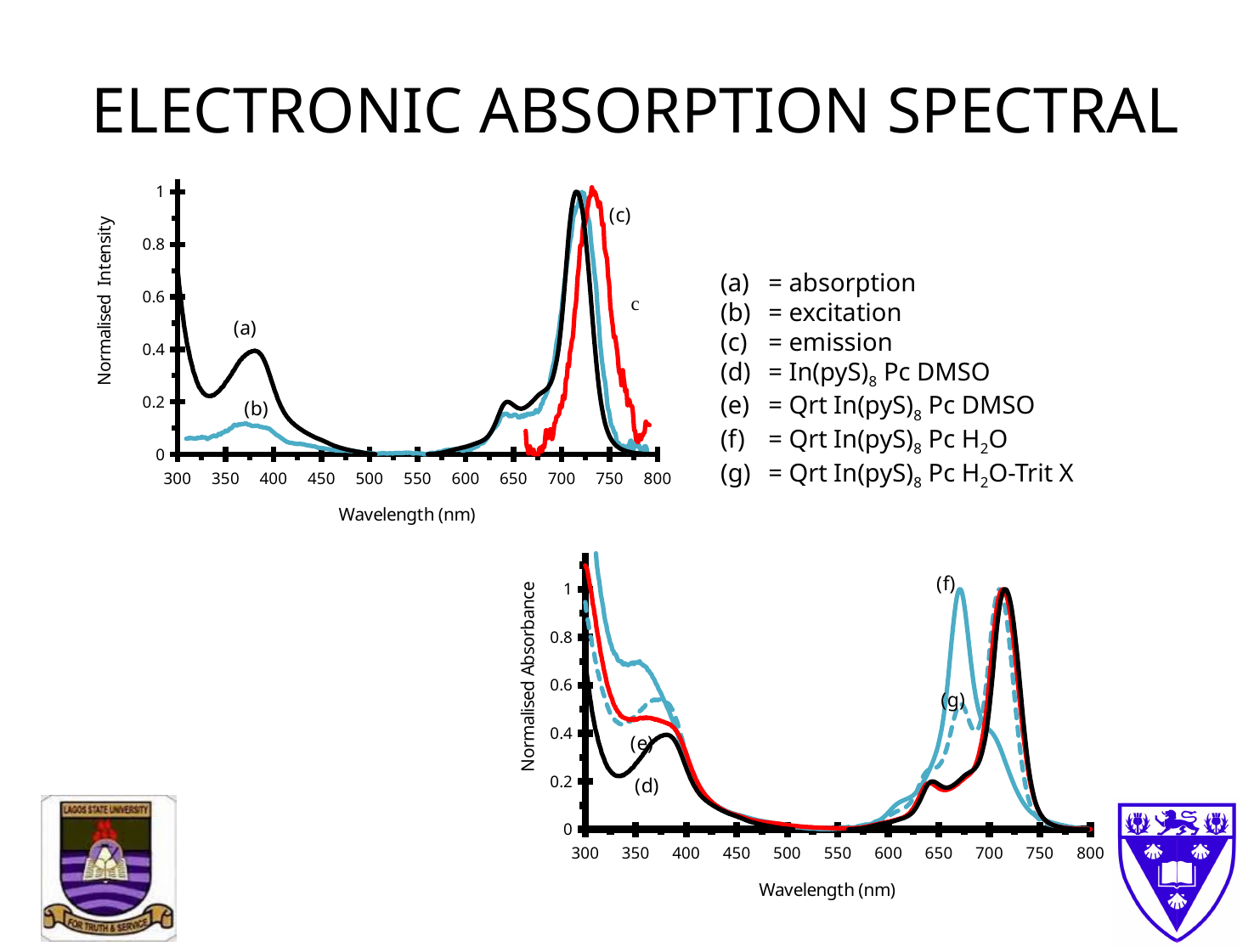
According to the legend text on the slide, what does curve (c) represent? emission In the top-left chart (Normalised Intensity), is the peak of curve (b) near 370 nm greater or less than 0.2? less In the top-left chart (Normalised Intensity), how many labelled curves are plotted? 3 What kind of chart is the bottom-right chart with the y-axis 'Normalised Absorbance'? line chart In the bottom-right chart (Normalised Absorbance), is the peak of curve (f) near 670 nm greater or less than 0.8? greater In the bottom-right chart (Normalised Absorbance), which curve has the higher value at 350 nm, (d) or (e)? (e) What is the y-axis label of the bottom-right chart? Normalised Absorbance In the top-left chart (Normalised Intensity), which curve has the higher peak near 380 nm, (a) or (b)? (a) In the top-left chart (Normalised Intensity), is the peak of curve (a) near 380 nm greater or less than 0.6? less What kind of chart is the top-left chart with the y-axis 'Normalised Intensity'? line chart In the bottom-right chart (Normalised Absorbance), how many labelled curves are plotted? 4